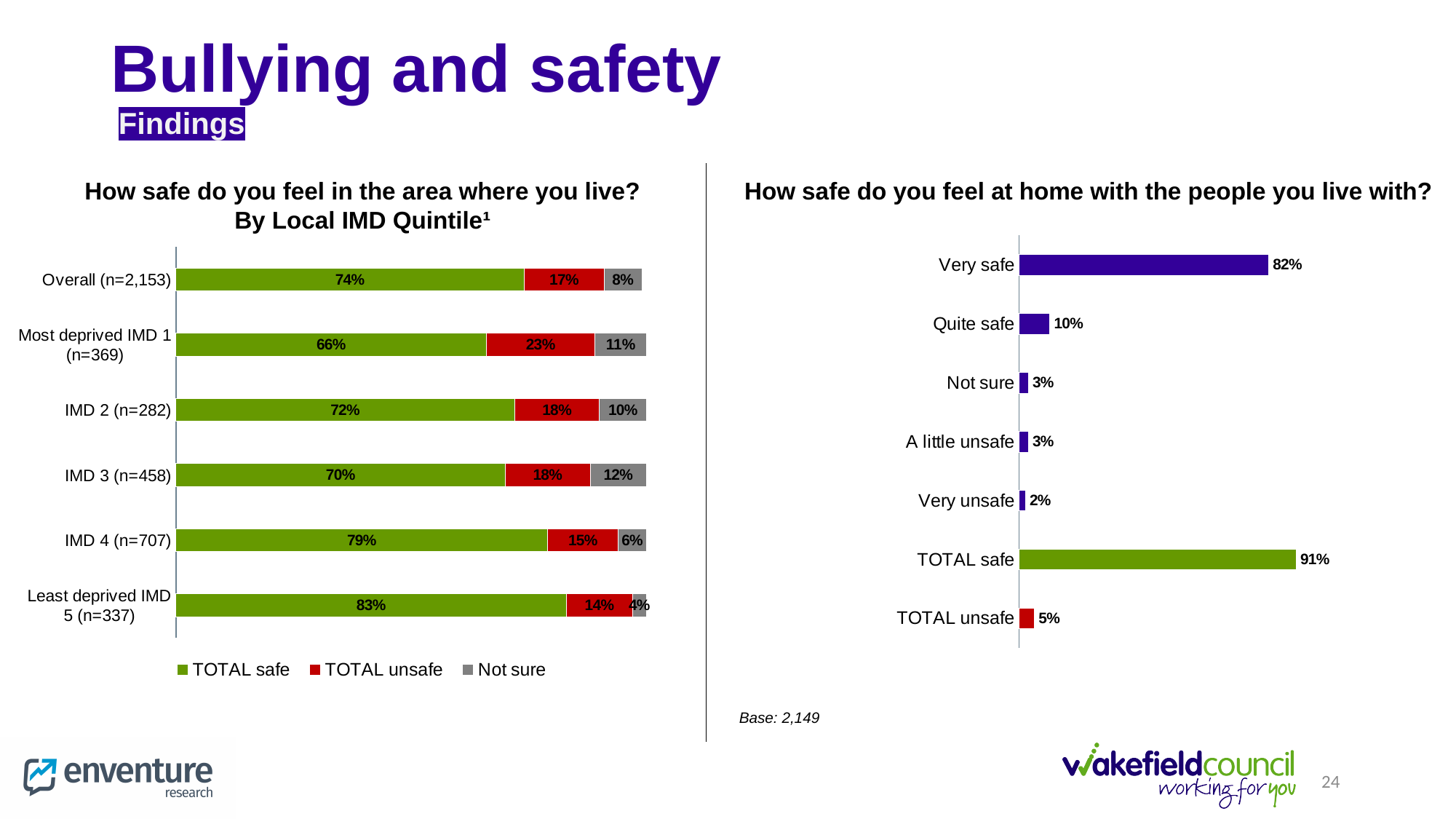
In the right chart (How safe do you feel at home with the people you live with?), what is the value for Quite safe? 10% In the left chart (How safe do you feel in the area where you live?), how many categories are shown? 6 In the right chart (How safe do you feel at home with the people you live with?), what is the difference between TOTAL safe and TOTAL unsafe? 86 percentage points In the right chart (How safe do you feel at home with the people you live with?), which category has the lowest value? Very unsafe In the left chart (How safe do you feel in the area where you live?), how many series does the legend list? 3 In the right chart (How safe do you feel at home with the people you live with?), is the value for Very safe larger or smaller than the value for TOTAL safe? smaller In the left chart (How safe do you feel in the area where you live?), what is the difference between the TOTAL safe values for Least deprived IMD 5 and Most deprived IMD 1? 17 percentage points In the left chart (How safe do you feel in the area where you live?), what is the TOTAL unsafe value for Most deprived IMD 1 (n=369)? 23% In the left chart (How safe do you feel in the area where you live?), what is the TOTAL safe value for IMD 4 (n=707)? 79% In the left chart (How safe do you feel in the area where you live?), which category has the highest TOTAL safe value? Least deprived IMD 5 (n=337) In the left chart (How safe do you feel in the area where you live?), which category has the lowest TOTAL safe value? Most deprived IMD 1 (n=369) What type of chart is the right chart (How safe do you feel at home with the people you live with?)? Bar chart